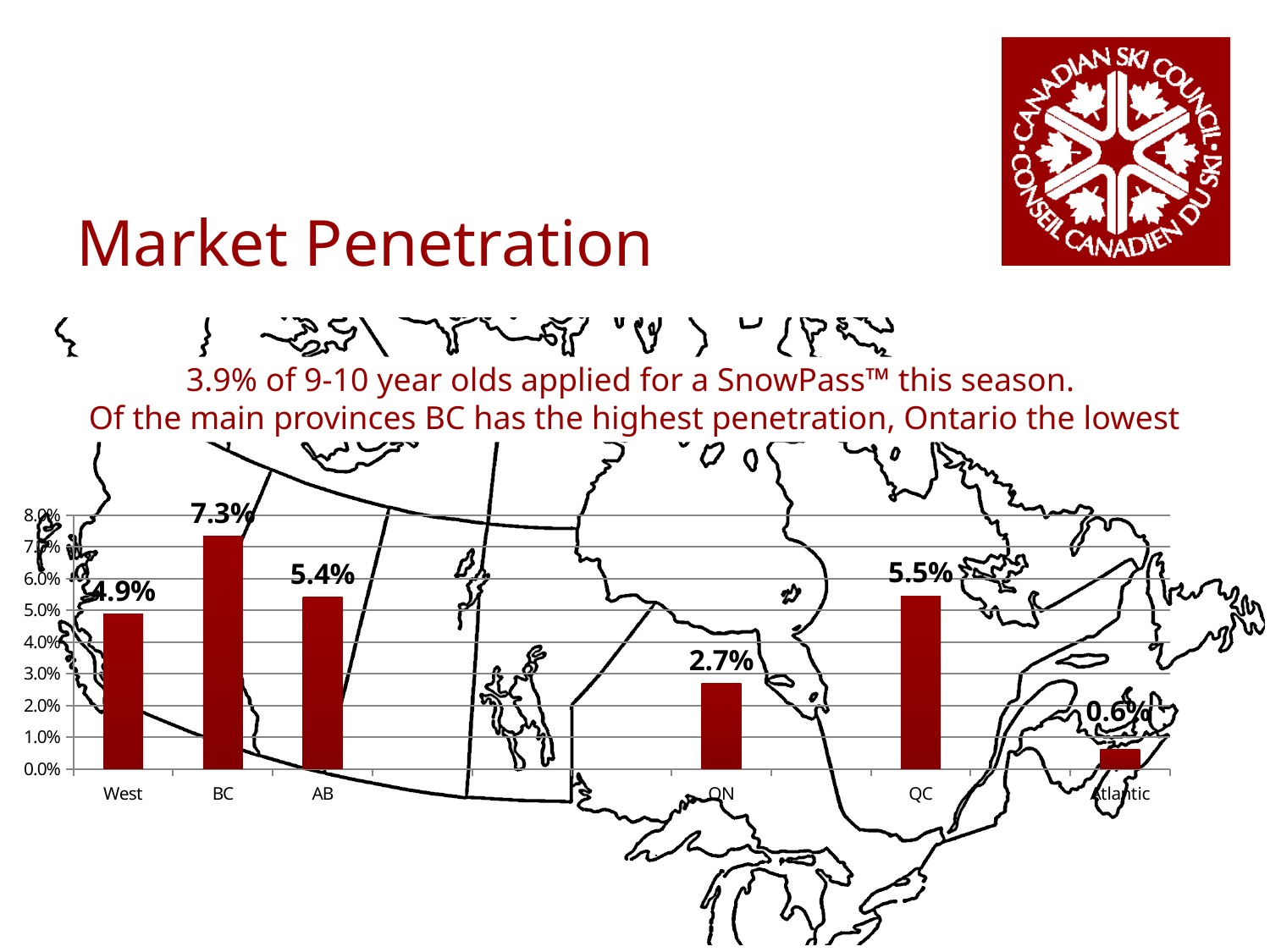
How many categories are shown on the x axis? 6 What is the difference between the values for QC and AB? 0.1% What is the value for BC? 7.3% What is the difference between the values for BC and ON? 4.6% What is the value for Atlantic? 0.6% Which is larger, the value for AB or the value for ON? AB What kind of chart is shown on the slide? Bar chart What is the value for West? 4.9% Which category has the lowest value? Atlantic What is the title of the slide containing the chart? Market Penetration What is the value for ON? 2.7% Which category has the highest value? BC